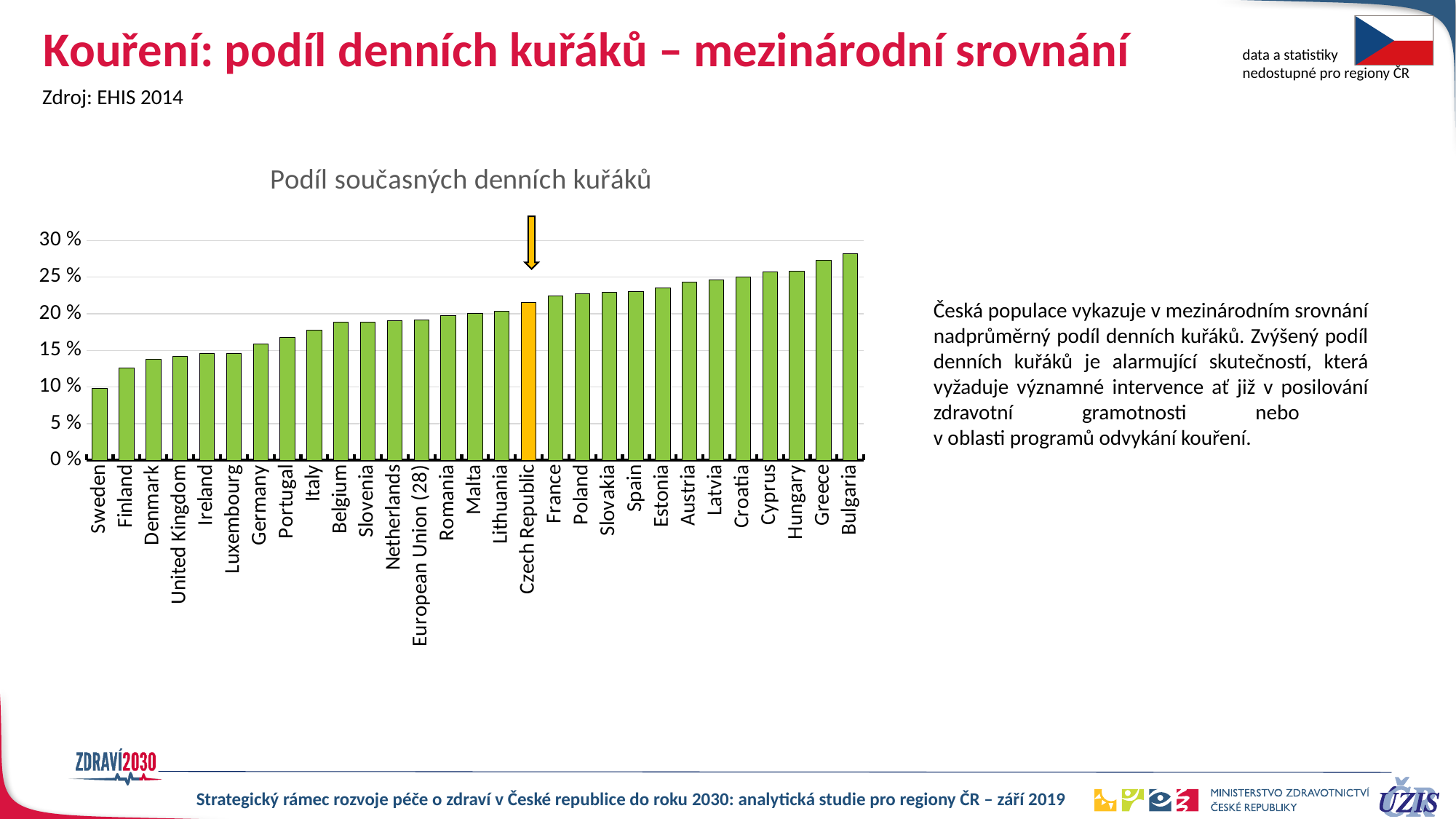
Is the value for Italy greater or less than 20 %? less Which category has the highest share of daily smokers in the chart? Bulgaria Is the value for Finland greater or less than 15 %? less What is the title of the chart? Podíl současných denních kuřáků Do the values rise or fall moving from left to right along the x axis? rise Which category has the lowest share of daily smokers in the chart? Sweden How many countries/categories are shown on the x axis of the chart? 29 Which has a larger share of daily smokers, Greece or Finland? Greece What kind of chart is shown on the slide? bar chart Is the value for Czech Republic greater or less than 20 %? greater Which country's bar is highlighted in a different colour (orange) from the others? Czech Republic